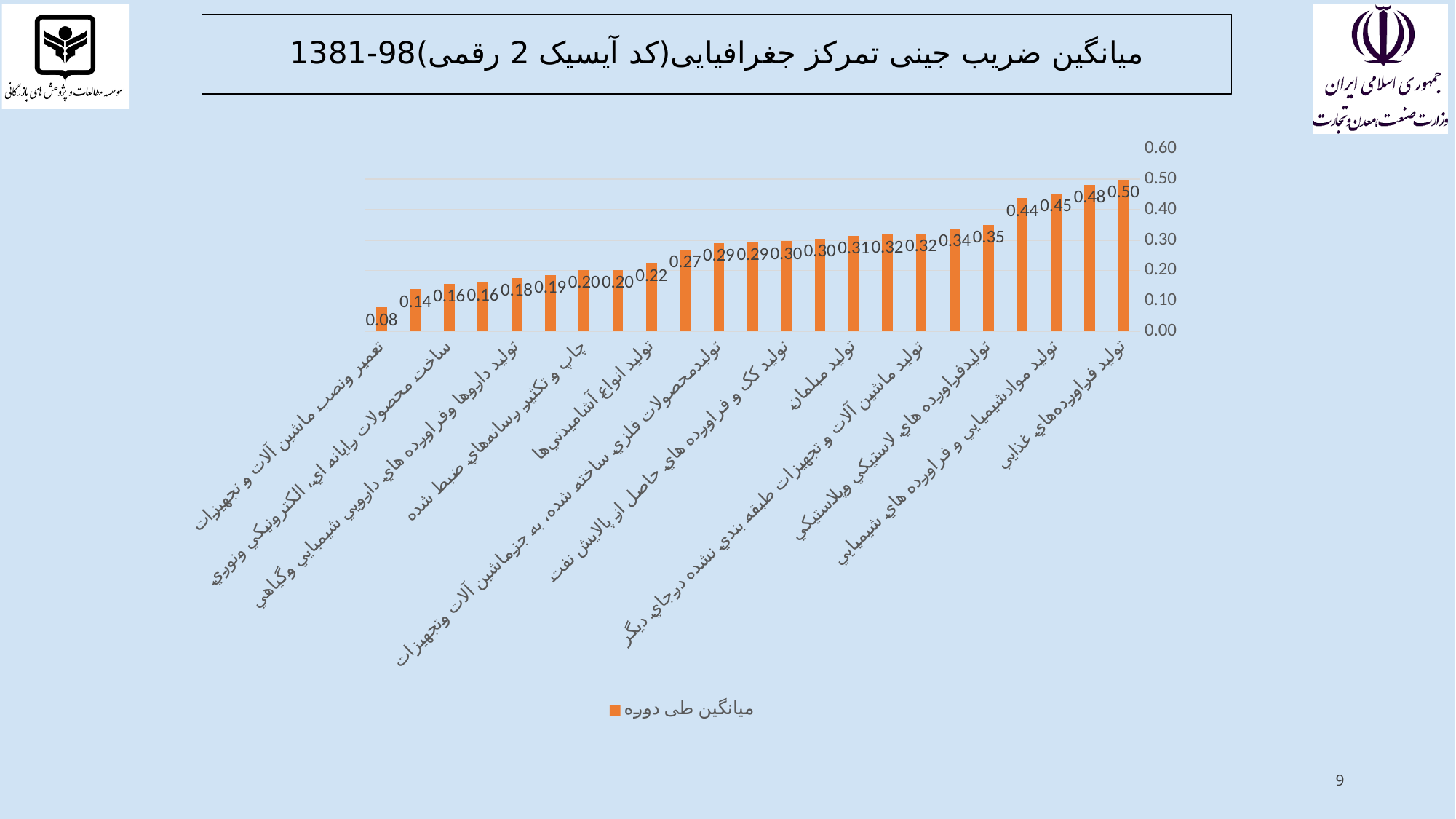
What is the highest value shown in the chart? 0.50 How many series does the legend list? 1 What is the lowest value shown in the chart? 0.08 How many bars are plotted in the chart? 23 Is the value for تعمیر ونصب ماشین آلات و تجهیزات greater or less than 0.10? less What type of chart is shown on the slide? bar chart What is the value for تولید فراورده‌های غذایی? 0.50 Which category has the lowest value? تعمیر ونصب ماشین آلات و تجهیزات Do the values rise or fall from left to right along the x axis? rise Which category has the highest value? تولید فراورده‌های غذایی What is the legend entry of the chart? میانگین طی دوره What is the difference between the highest value (0.50) and the lowest value (0.08)? 0.42